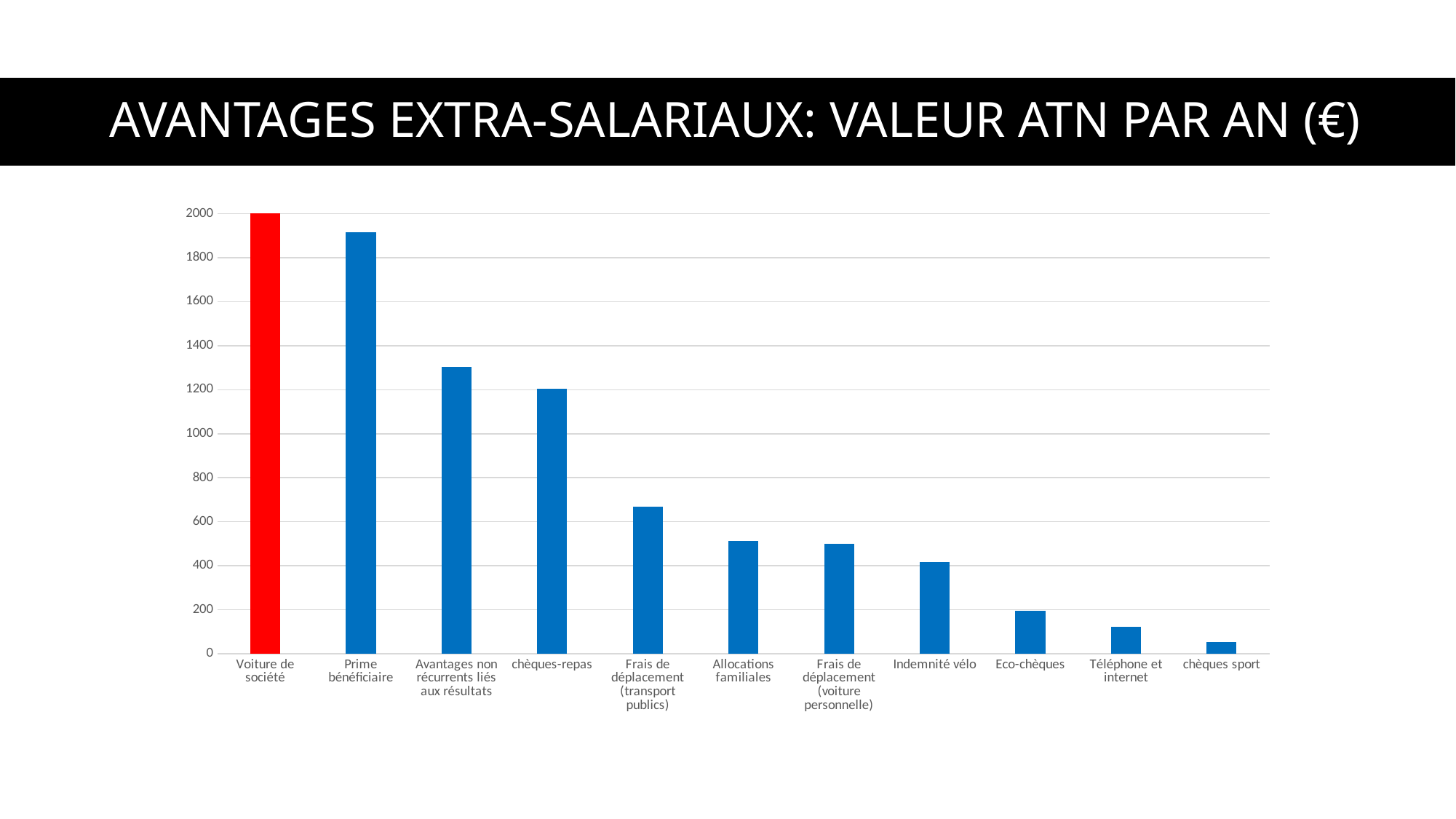
How many categories are shown on the x axis of the chart? 11 Is the value for Frais de déplacement (transport publics) greater or less than 600? greater Is the value for chèques-repas greater or less than 1400? less What kind of chart is shown on the slide? bar chart Is the value for Prime bénéficiaire greater or less than 1800? greater Which is larger, the value for Allocations familiales or the value for Indemnité vélo? Allocations familiales Do the values rise or fall from left to right along the x axis? fall Which category has the highest value in the chart? Voiture de société Which bar in the chart is coloured red? Voiture de société Which category has the lowest value in the chart? chèques sport